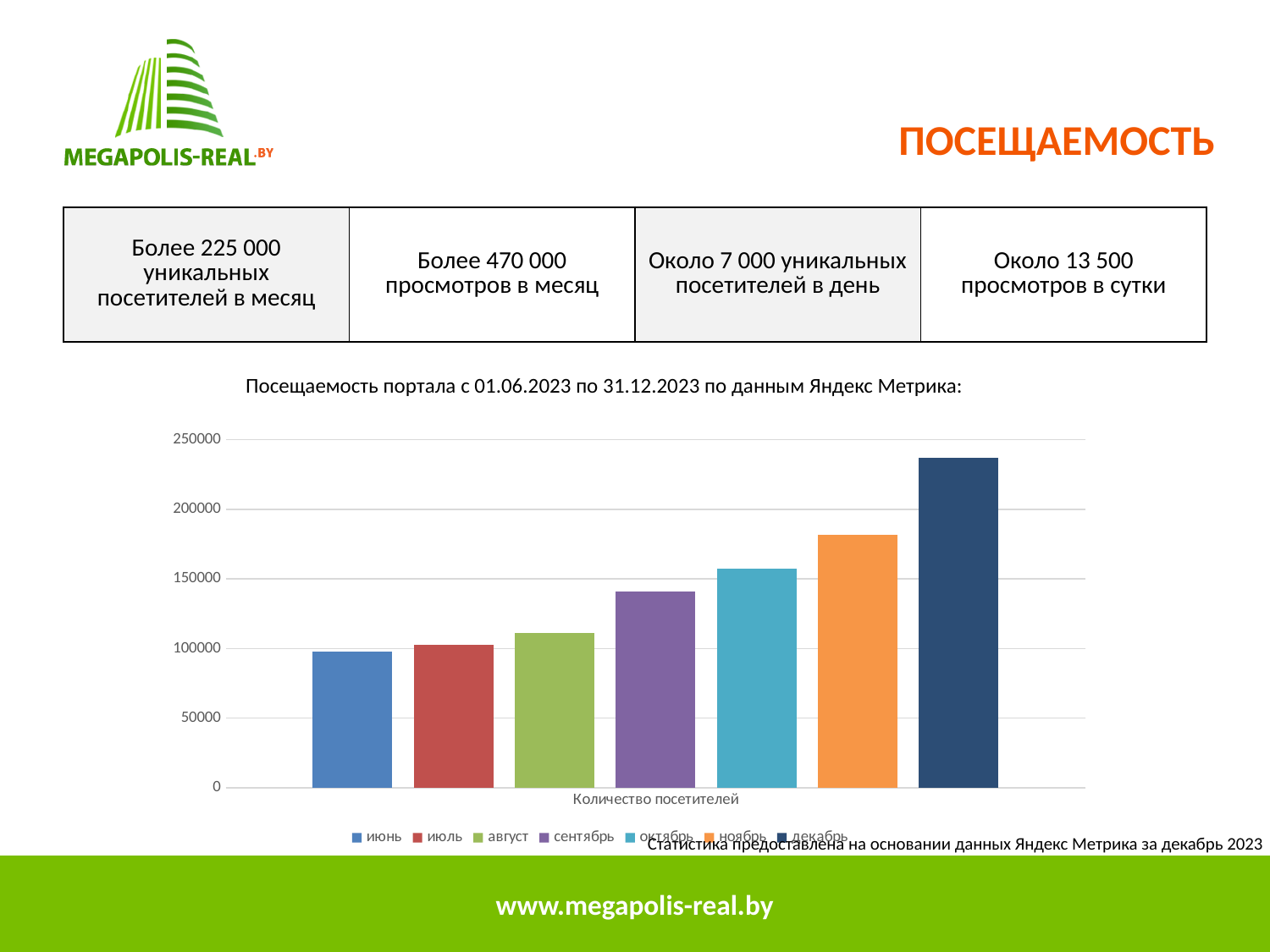
Which month has the lowest number of visitors in the chart? июнь What label appears under the bars on the x axis? Количество посетителей Which month has the highest number of visitors in the chart? декабрь Do the bars rise or fall from июнь to декабрь? rise How many series does the chart legend list? 7 Which is larger, the value for декабрь or the value for июль? декабрь Is the value for сентябрь greater or less than 150000? less Is the value for декабрь greater or less than 200000? greater Is the value for ноябрь greater or less than 200000? less What is the title shown above the chart? Посещаемость портала с 01.06.2023 по 31.12.2023 по данным Яндекс Метрика: What kind of chart is shown on the slide? bar chart